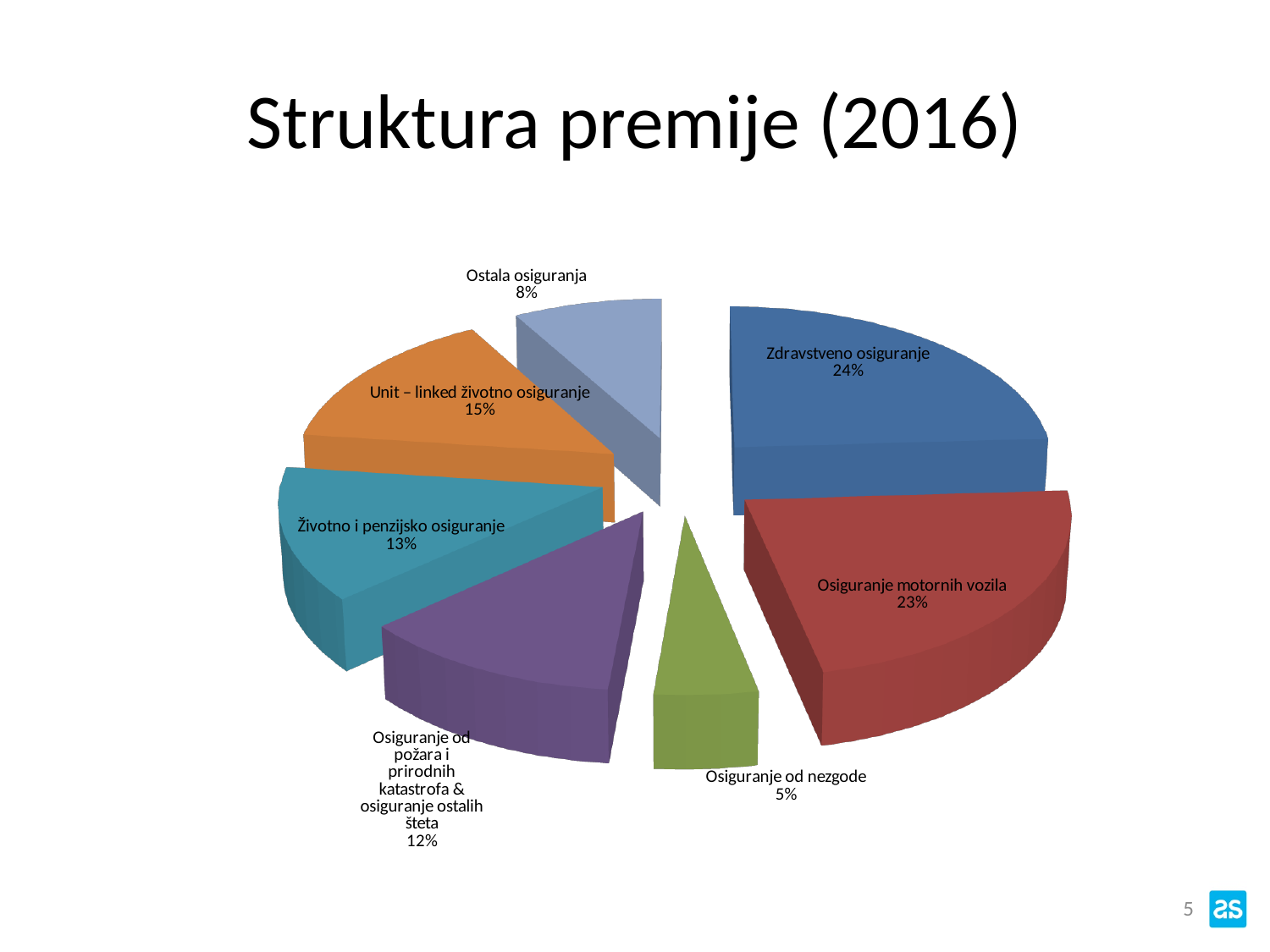
What share of the premium structure is Osiguranje motornih vozila? 23% What share of the premium structure is Osiguranje od nezgode? 5% What is the difference in percentage points between Unit – linked životno osiguranje and Ostala osiguranja? 7 percentage points How many slices does the pie chart have? 7 What is the title of the slide containing the pie chart? Struktura premije (2016) What share of the premium structure is Unit – linked životno osiguranje? 15% What share of the premium structure is Ostala osiguranja? 8% Which category has the largest share of the pie? Zdravstveno osiguranje What kind of chart is shown on the slide? pie chart What share of the premium structure is Životno i penzijsko osiguranje? 13% What share of the premium structure is Zdravstveno osiguranje? 24% Which category has the smallest share of the pie? Osiguranje od nezgode